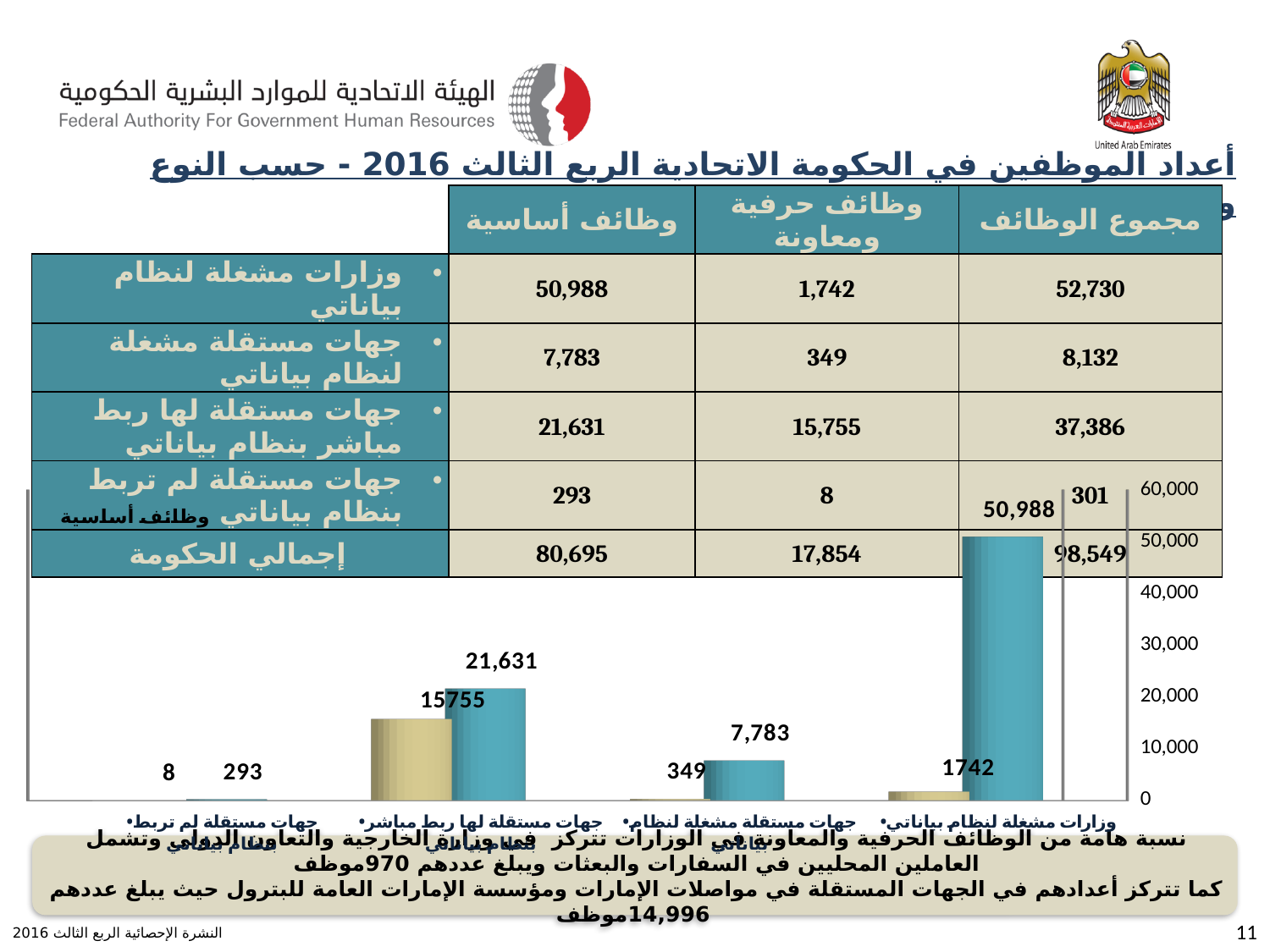
In the bar chart, what is the value of وظائف أساسية for جهات مستقلة لها ربط مباشر بنظام بياناتي? 21,631 In the bar chart, what is the difference between وظائف أساسية (21,631) and وظائف حرفية ومعاونة (15755) for جهات مستقلة لها ربط مباشر بنظام بياناتي? 5,876 Which category has the smallest bar in the chart? جهات مستقلة لم تربط بنظام بياناتي In the bar chart, which is larger: وظائف حرفية ومعاونة for جهات مستقلة لها ربط مباشر (15755) or وظائف أساسية for جهات مستقلة مشغلة لنظام بياناتي (7,783)? 15755 In the bar chart, what is the value of وظائف حرفية ومعاونة for جهات مستقلة لم تربط بنظام بياناتي? 8 In the bar chart, what is the value of وظائف أساسية for جهات مستقلة مشغلة لنظام بياناتي? 7,783 How many categories are shown along the x axis of the bar chart? 4 In the bar chart, what is the value of وظائف أساسية for وزارات مشغلة لنظام بياناتي? 50,988 What kind of chart is shown on the slide? bar chart Is the value of وظائف أساسية for وزارات مشغلة لنظام بياناتي greater or less than 40,000? greater In the bar chart, what is the value of وظائف حرفية ومعاونة for جهات مستقلة لها ربط مباشر بنظام بياناتي? 15755 Which category has the tallest bar in the chart? وزارات مشغلة لنظام بياناتي